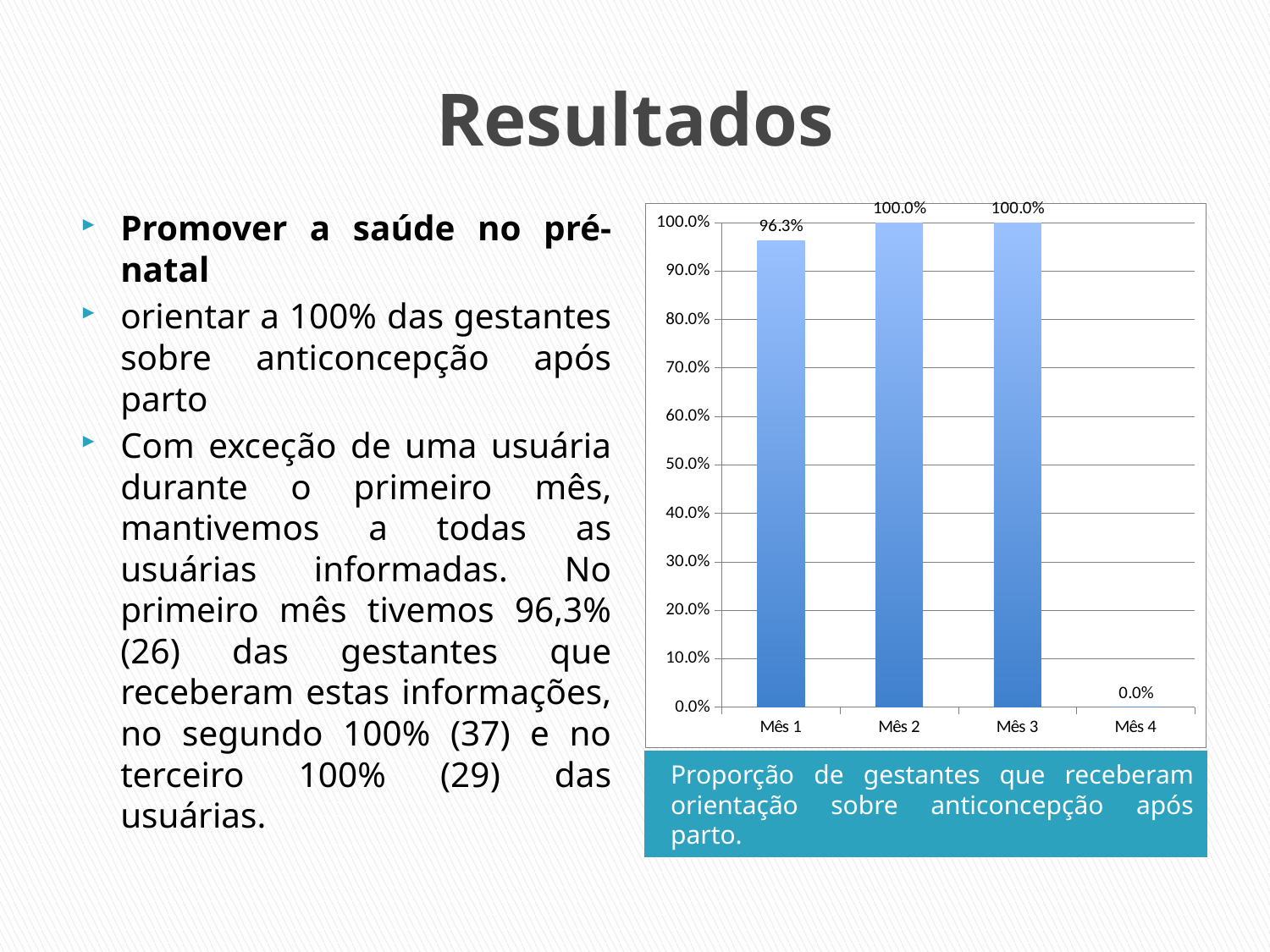
What is the highest value shown on the y axis? 100.0% What is the value for Mês 2? 100.0% What is the value for Mês 4? 0.0% What kind of chart is shown on the slide? bar chart What is the difference between the values for Mês 2 and Mês 1? 3.7% What is the value for Mês 1? 96.3% Do the values for Mês 2 and Mês 3 differ? No, both are 100.0% Which category has the lowest value? Mês 4 What does the caption below the chart say the chart shows? Proporção de gestantes que receberam orientação sobre anticoncepção após parto. Which is larger, the value for Mês 1 or the value for Mês 3? Mês 3 How many categories are shown on the x axis? 4 Is the value for Mês 1 greater or less than 90.0%? greater